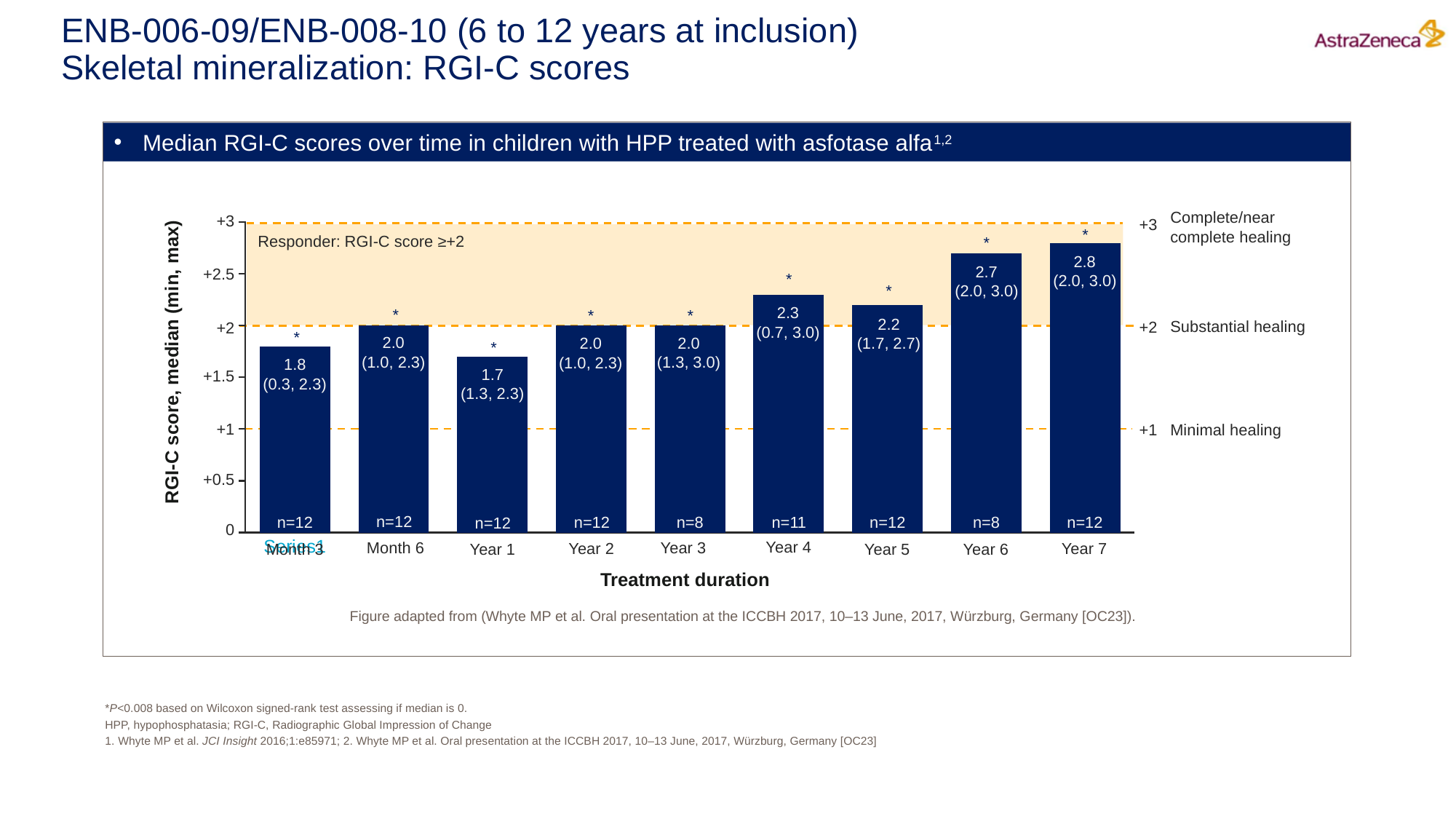
What type of chart is used to show the median RGI-C scores? Bar chart Which treatment duration has the highest median RGI-C score? Year 7 Which treatment duration has the lowest median RGI-C score? Year 1 What is the median RGI-C score at Year 4? 2.3 What is the label of the x axis? Treatment duration What is the median RGI-C score at Year 6? 2.7 What is the difference between the median RGI-C score at Year 7 and at Month 3? 1.0 How many treatment duration time points are plotted on the chart? 9 Which has a higher median RGI-C score, Year 5 or Year 6? Year 6 What is the median RGI-C score at Month 3? 1.8 Is the median RGI-C score at Year 1 greater or less than +2? less What is the n value shown for the Year 3 bar? n=8